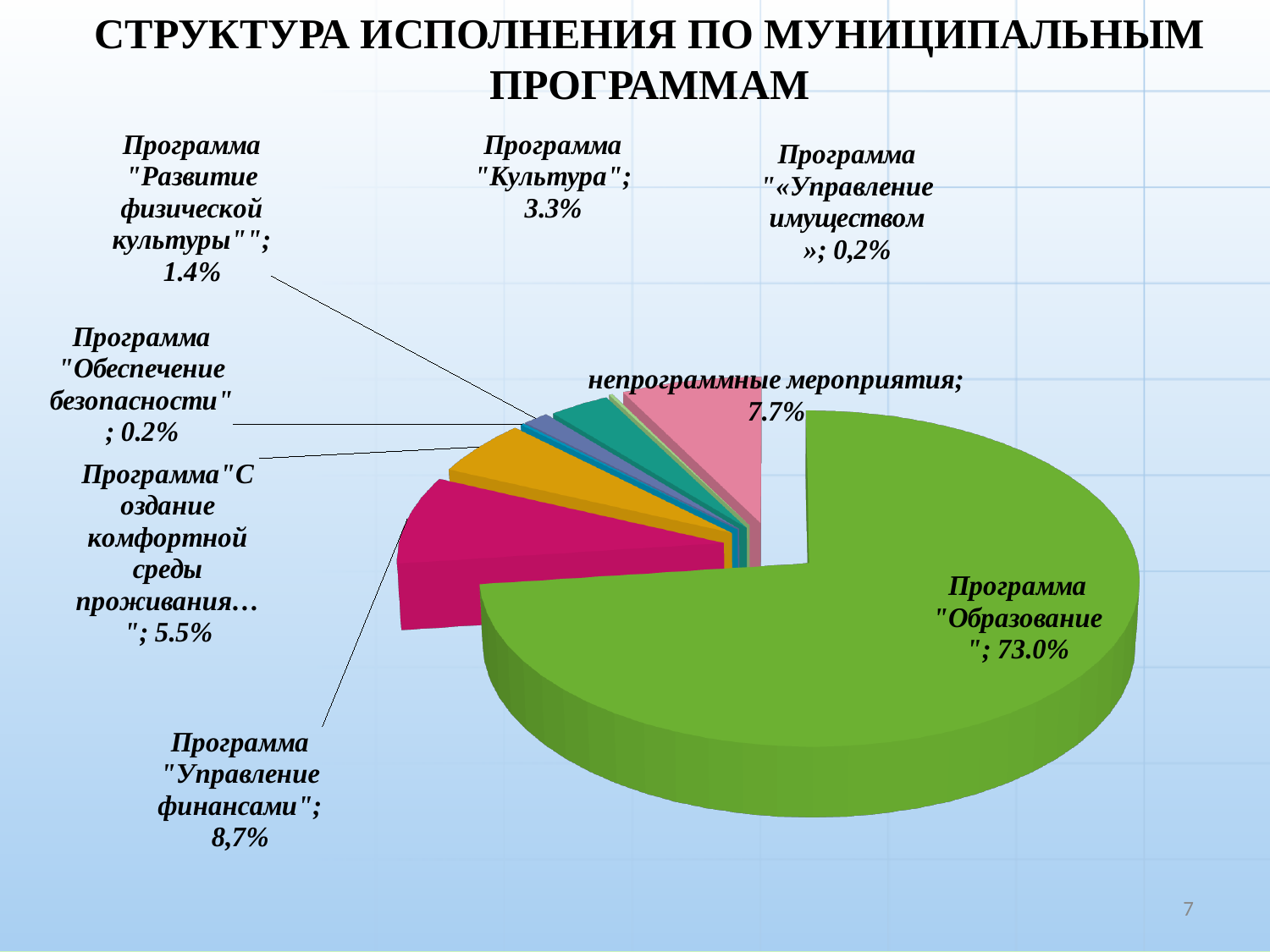
What is the value shown for Программа "Управление финансами"? 8,7% What is the value shown for непрограммные мероприятия? 7.7% What kind of chart is shown on the slide? pie chart What is the difference between the shares of Программа "Образование" and непрограммные мероприятия? 65.3% Which is larger: Программа "Управление финансами" or непрограммные мероприятия? Программа "Управление финансами" What is the value shown for Программа "Развитие физической культуры"? 1.4% How many slices does the pie chart have? 8 What is the value shown for Программа "Создание комфортной среды проживания…"? 5.5% What share does Программа "Образование" have in the pie chart? 73.0% What is the title of the chart on the slide? СТРУКТУРА ИСПОЛНЕНИЯ ПО МУНИЦИПАЛЬНЫМ ПРОГРАММАМ What is the value shown for Программа "Культура"? 3.3% Which program has the largest share of the pie? Программа "Образование"